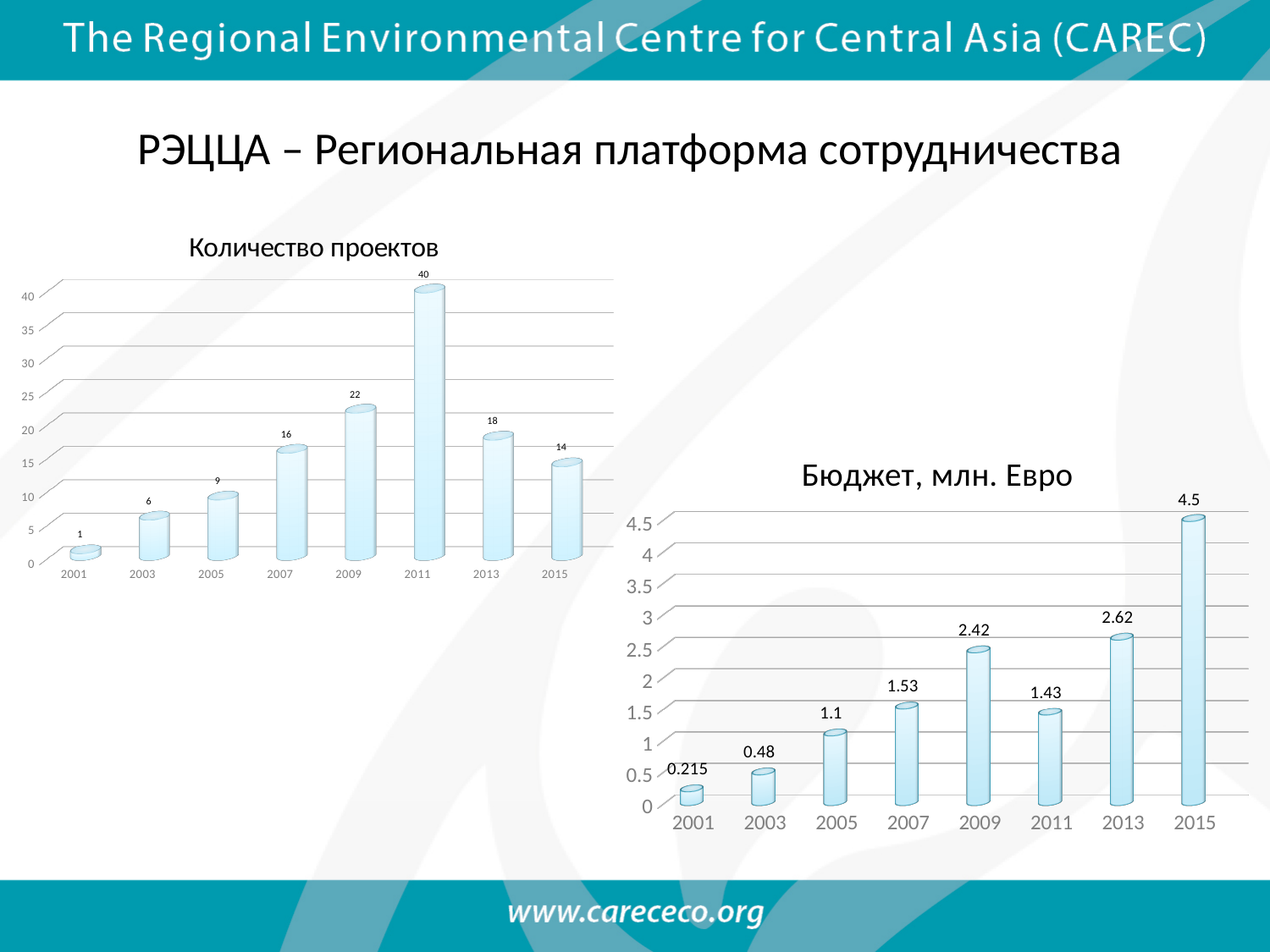
In the 'Бюджет, млн. Евро' chart, which year has the highest value? 2015 In the 'Бюджет, млн. Евро' chart, what is the value for 2015? 4.5 In the 'Количество проектов' chart, which year has the lowest value? 2001 What kind of chart is the 'Бюджет, млн. Евро' chart? Bar chart In the 'Количество проектов' chart, which is larger, the value for 2013 or the value for 2015? 2013 In the 'Количество проектов' chart, what is the difference between the values for 2011 and 2009? 18 In the 'Количество проектов' chart, how many years are shown on the x axis? 8 In the 'Количество проектов' chart, what is the value for 2005? 9 In the 'Количество проектов' chart, what is the value for 2011? 40 In the 'Бюджет, млн. Евро' chart, what is the difference between the values for 2013 and 2011? 1.19 In the 'Бюджет, млн. Евро' chart, is the value for 2009 greater or less than 2? greater In the 'Бюджет, млн. Евро' chart, what is the value for 2001? 0.215